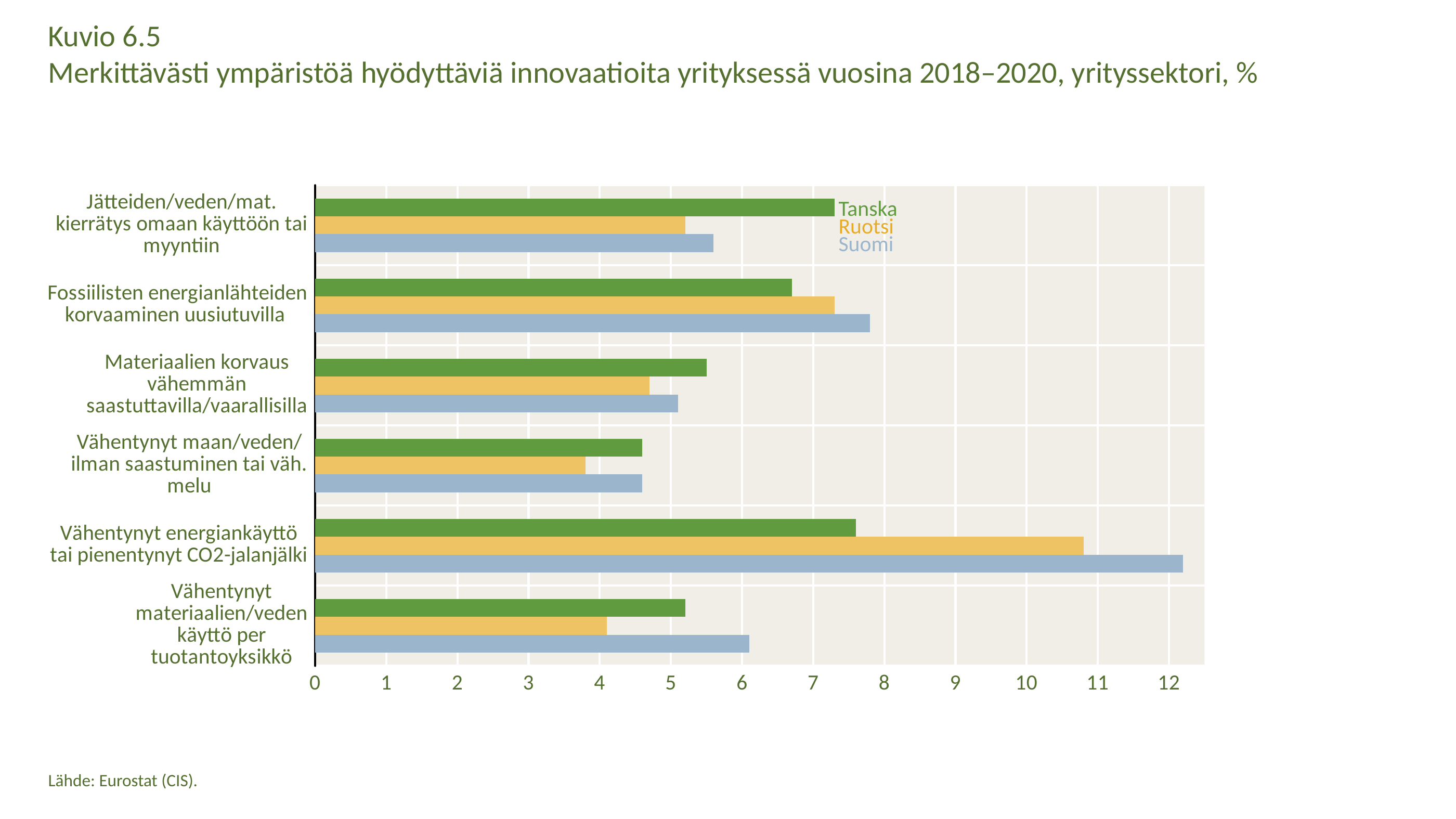
In 'Jätteiden/veden/mat. kierrätys omaan käyttöön tai myyntiin', which is larger, Tanska or Ruotsi? Tanska Is the value for Tanska in 'Jätteiden/veden/mat. kierrätys omaan käyttöön tai myyntiin' greater or less than 7? greater Which category has the highest value for Suomi? Vähentynyt energiankäyttö tai pienentynyt CO2-jalanjälki Is the value for Suomi in 'Vähentynyt energiankäyttö tai pienentynyt CO2-jalanjälki' greater or less than 12? greater Which colour represents Ruotsi in the chart? yellow How many series does the legend list? 3 Is the value for Ruotsi in 'Vähentynyt maan/veden/ilman saastuminen tai väh. melu' greater or less than 4? less How many categories are shown on the vertical axis? 6 In 'Vähentynyt materiaalien/veden käyttö per tuotantoyksikkö', which is larger, Ruotsi or Suomi? Suomi In 'Fossiilisten energianlähteiden korvaaminen uusiutuvilla', which is larger, Suomi or Tanska? Suomi Which category has the lowest value for Ruotsi? Vähentynyt maan/veden/ilman saastuminen tai väh. melu What kind of chart is shown on the slide? bar chart